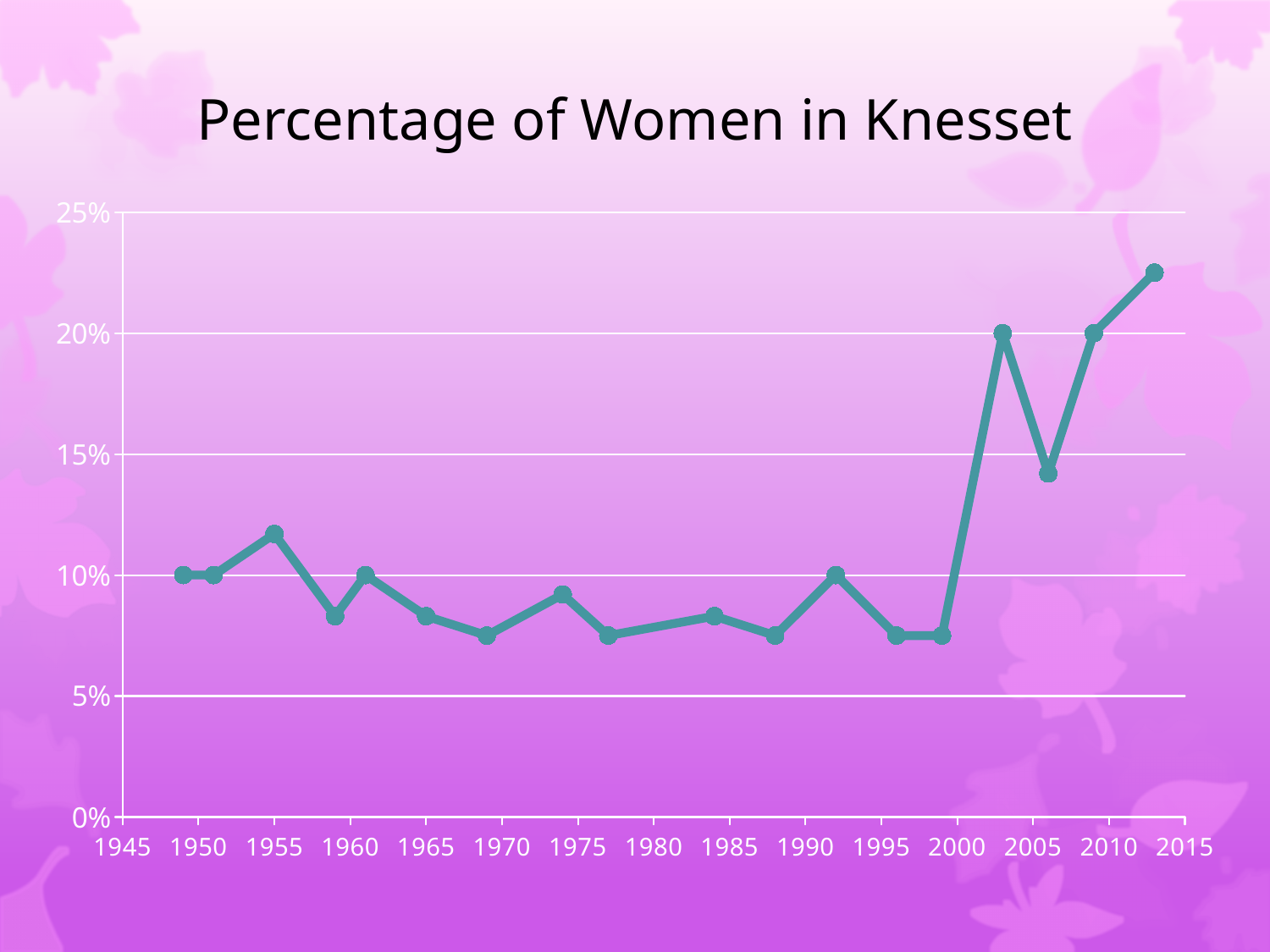
What is the value of the first plotted point (just before 1950)? 10% What type of chart is shown on the slide? line chart What is the title of the chart? Percentage of Women in Knesset Is the value of the plotted point just before 2000 greater or less than 10%? less Is the value of the plotted point between 2005 and 2010 greater or less than 10%? greater How many series are plotted on the chart? 1 What is the value of the plotted point just after 2000? 20% Which plotted point has the highest value? the last point, just after 2010 Is the value of the last plotted point (just after 2010) greater or less than 20%? greater Which is larger, the value of the first plotted point or the value of the last plotted point? the last plotted point How many data points are plotted on the line? 18 Does the percentage of women in the Knesset generally rise or fall between 2000 and 2015? rise